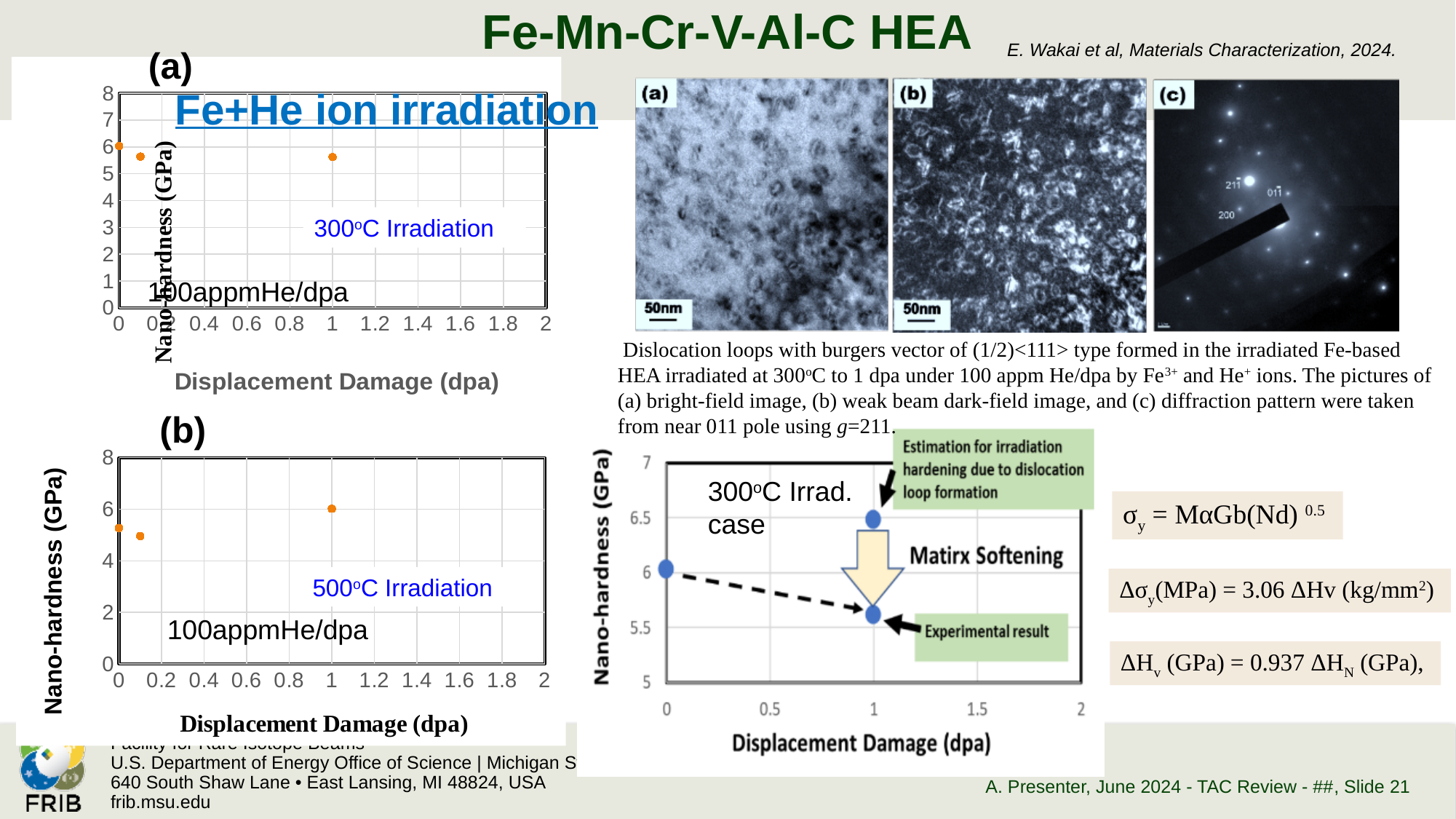
In chart (b), the 500°C Irradiation chart, which point has the higher nano-hardness: the one at 0 dpa or the one at 1 dpa? 1 dpa In chart (b), the 500°C Irradiation chart, does the nano-hardness rise or fall from 0 dpa to 1 dpa? rise In chart (a), the 300°C Irradiation chart, does the nano-hardness rise or fall from 0 dpa to 1 dpa? fall How many data points are plotted in chart (b), the 500°C Irradiation chart? 3 How many data points are plotted in chart (a), the 300°C Irradiation chart? 3 In chart (a), the 300°C Irradiation chart, is the nano-hardness at 1 dpa greater or less than 6 GPa? less In chart (b), the 500°C Irradiation chart, is the nano-hardness at 0 dpa greater or less than 4 GPa? greater In the bottom-right chart labelled 300°C Irrad. case, is the experimental result at 1 dpa greater or less than 6 GPa? less In chart (a), the 300°C Irradiation chart, which point has the higher nano-hardness: the one at 0 dpa or the one at 1 dpa? 0 dpa What is the x-axis title of chart (b), the 500°C Irradiation chart? Displacement Damage (dpa) What kind of chart is chart (a), labelled 300°C Irradiation? scatter chart